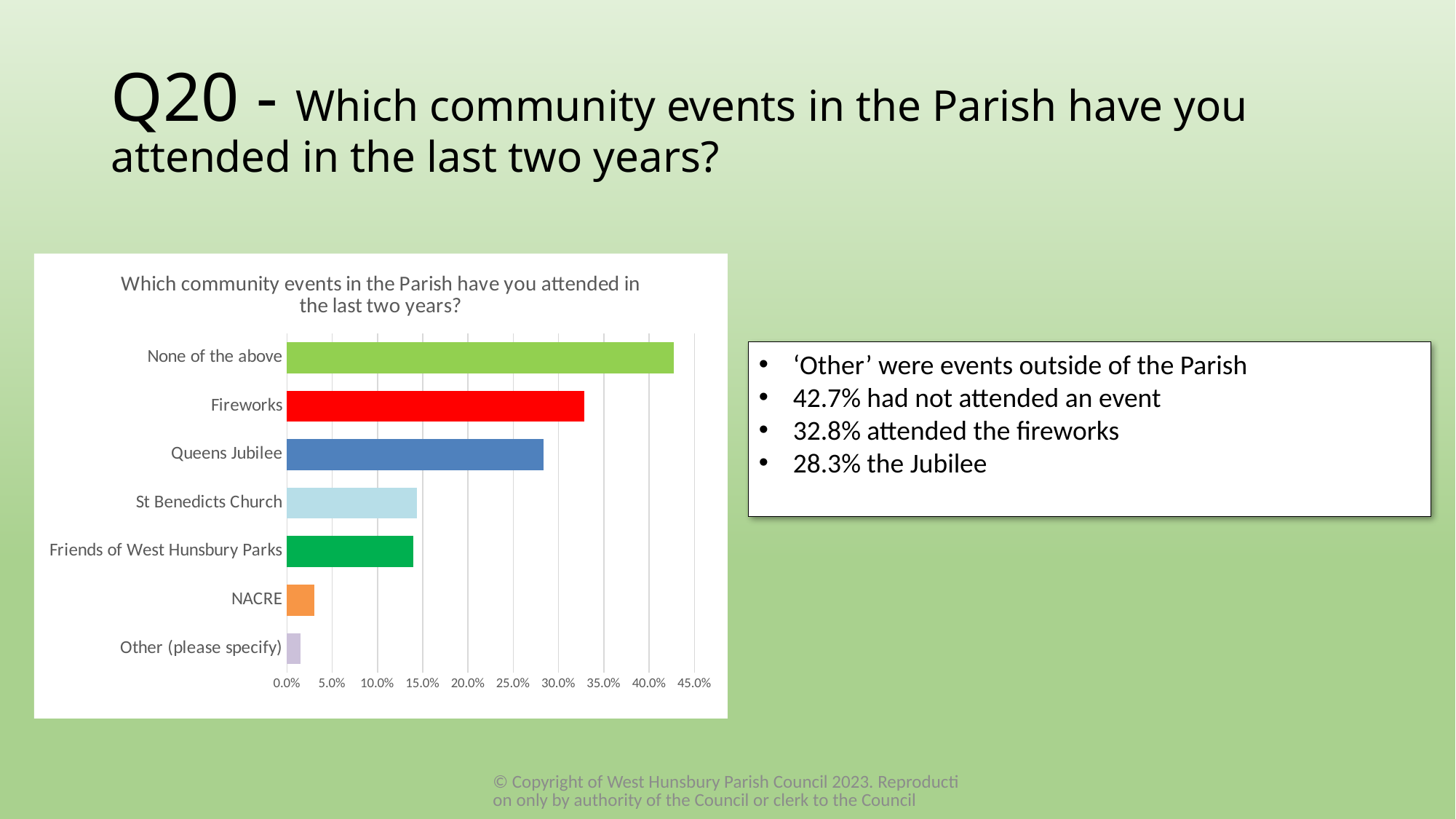
What kind of chart is shown on the slide? bar chart Is the value for St Benedicts Church greater or less than 10.0%? greater Which is larger, the value for Fireworks or the value for Queens Jubilee? Fireworks What percentage of respondents attended the Queens Jubilee? 28.3% What is the difference between the value for None of the above and the value for Fireworks? 9.9% Which category has the lowest value in the chart? Other (please specify) Which category has the highest value in the chart? None of the above How many categories does the chart show? 7 Is the value for NACRE greater or less than 5.0%? less What colour is the bar for Fireworks? red What percentage of respondents attended the Fireworks? 32.8% What percentage of respondents had not attended an event (None of the above)? 42.7%